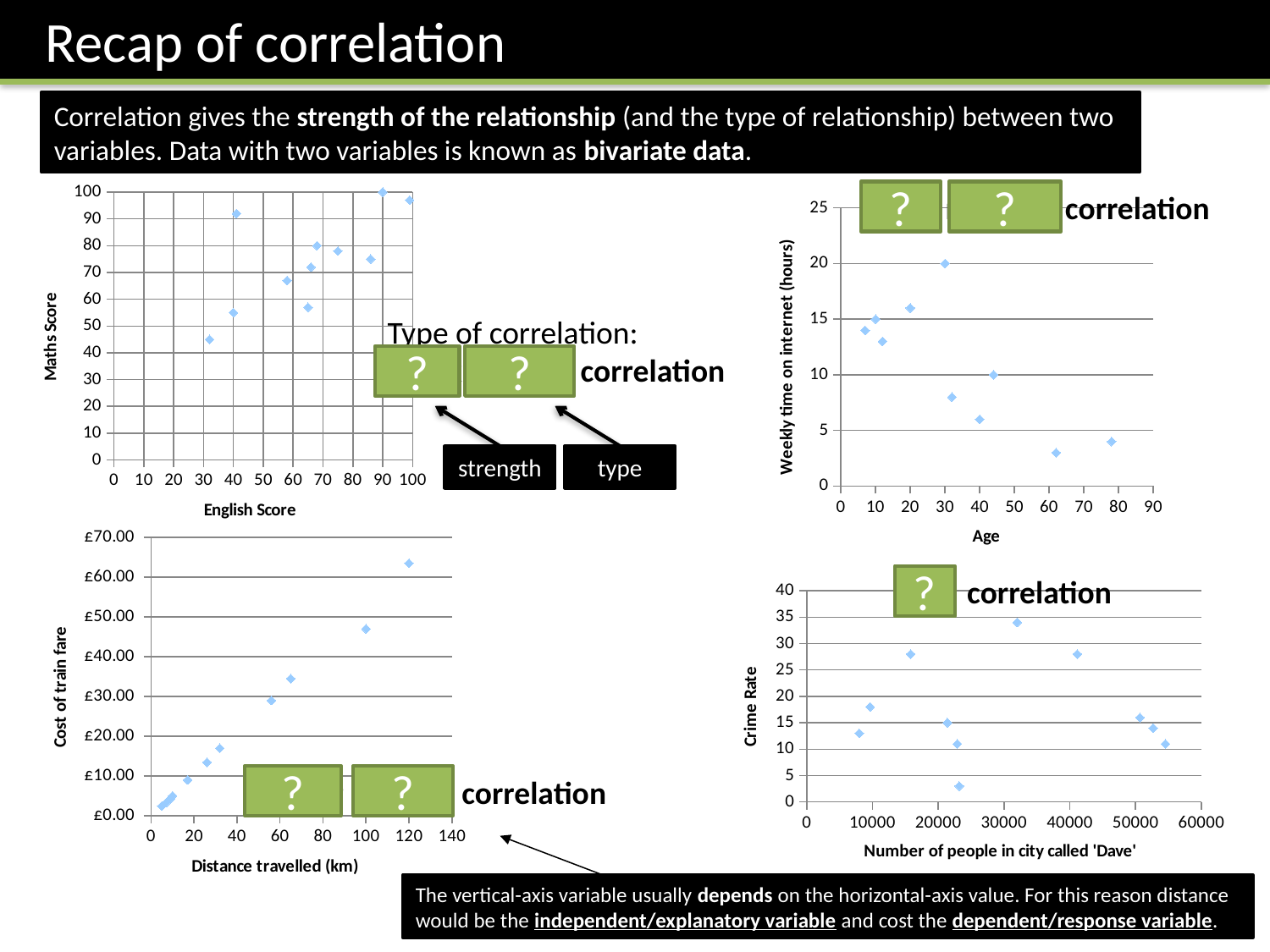
What is the label of the vertical axis on the chart with the x-axis 'Distance travelled (km)'? Cost of train fare In the chart with the x-axis 'Distance travelled (km)', is the cost for the point at 100 km greater or less than £50.00? less What is the label of the vertical axis on the chart with the x-axis 'Number of people in city called 'Dave''? Crime Rate What kind of chart is the chart with the x-axis 'English Score'? scatter chart In the chart with the x-axis 'Distance travelled (km)', does the cost of train fare rise or fall as distance increases? rise In the chart with the x-axis 'English Score', do the Maths Score values generally rise or fall as English Score increases? rise In the chart with the x-axis 'Number of people in city called 'Dave'', is the crime rate for the point at about 32000 people greater or less than 30? greater In the chart with the x-axis 'Age', is the weekly time on internet for the point at age 62 greater or less than 5? less In the chart with the x-axis 'Age', do the weekly internet hours generally rise or fall as age increases? fall In the chart with the x-axis 'Age', how many data points are plotted? 10